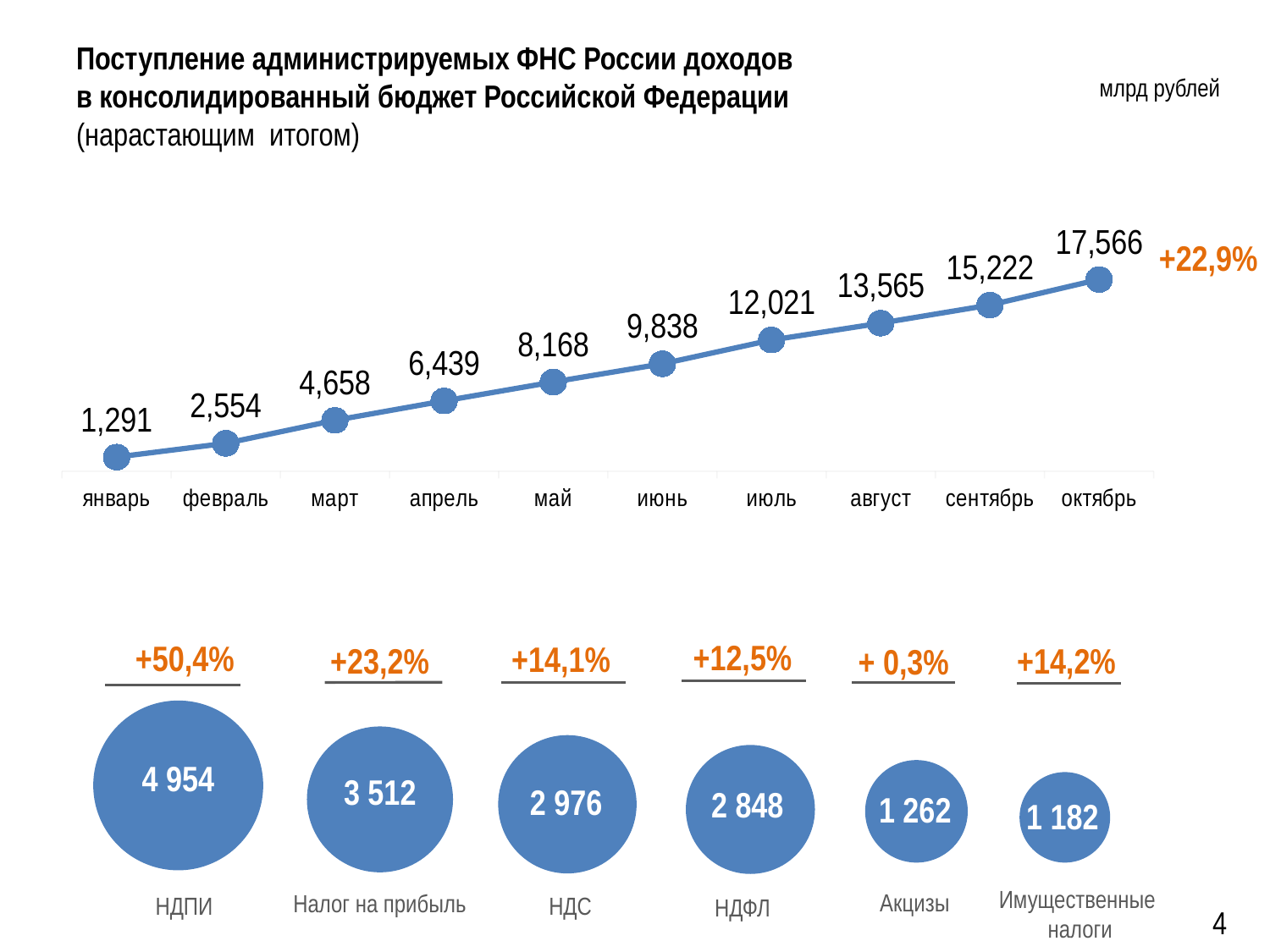
In the line chart at the top, how many months are plotted? 10 In the bubble chart at the bottom, which category has the lowest value? Имущественные налоги In the bubble chart at the bottom, what is the difference between the values for НДПИ and НДС? 1 978 In the line chart at the top, do the values rise or fall from январь to октябрь? rise In the line chart at the top, what is the value for май? 8,168 In the line chart at the top, what percentage growth is shown next to the last point? +22,9% In the line chart at the top, what is the value for октябрь? 17,566 In the line chart at the top, what is the difference between the values for октябрь and сентябрь? 2,344 In the line chart at the top, which month has the lowest value? январь In the bubble chart at the bottom, which category has the highest value? НДПИ In the bubble chart at the bottom, what is the value for НДФЛ? 2 848 In the bubble chart at the bottom, what percentage change is shown above Акцизы? + 0,3%